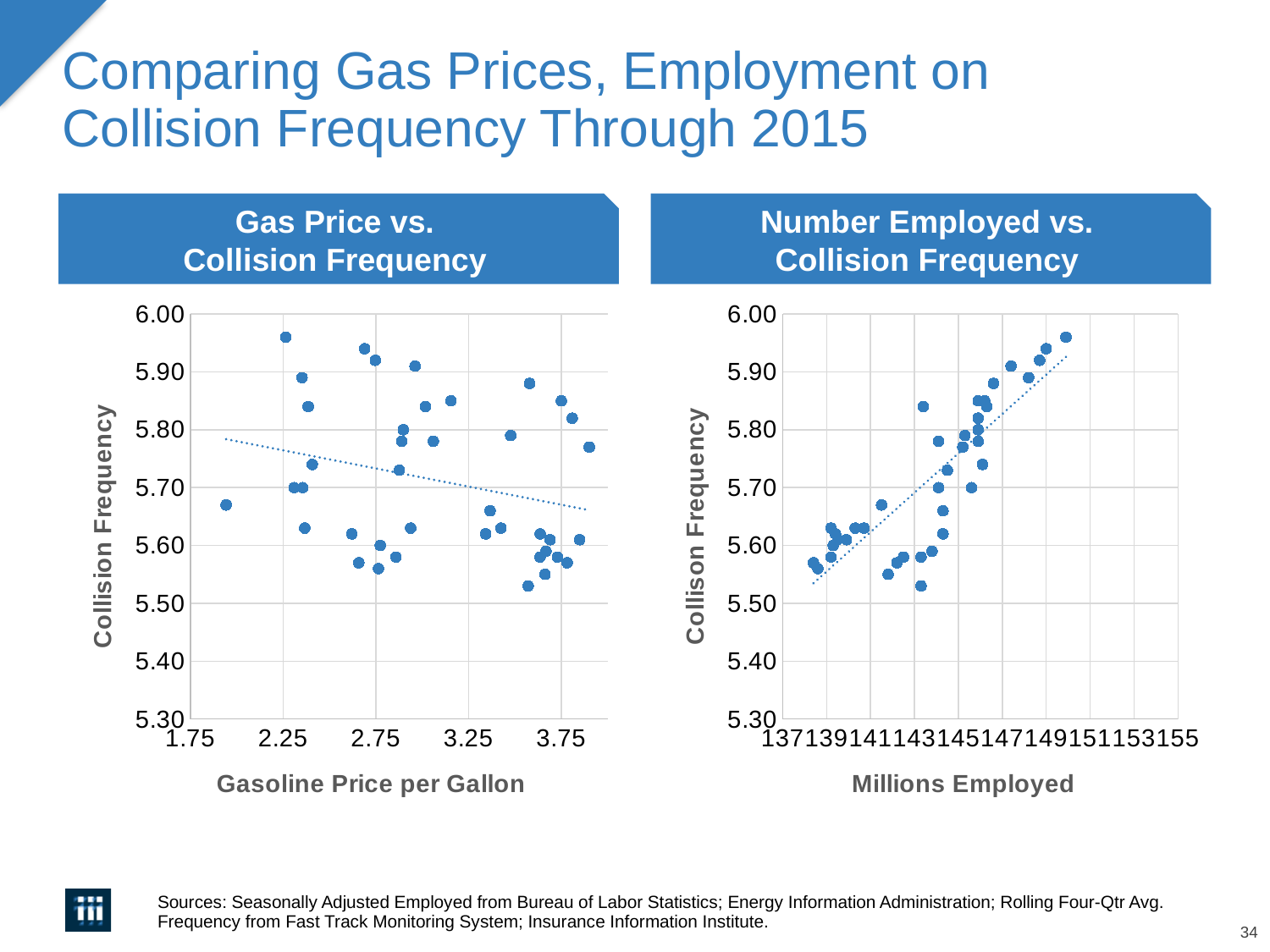
Which of the two charts shows a positive relationship between the x-axis variable and collision frequency? Number Employed vs. Collision Frequency What kind of chart is the 'Number Employed vs. Collision Frequency' chart? Scatter chart In the 'Number Employed vs. Collision Frequency' chart, are the collision frequencies of the points near 137-138 million employed greater or less than 5.70? less In the 'Gas Price vs. Collision Frequency' chart, is the collision frequency of the highest point (near a gas price of 2.25) greater or less than 5.90? greater What is the x-axis title of the 'Gas Price vs. Collision Frequency' chart? Gasoline Price per Gallon In the 'Gas Price vs. Collision Frequency' chart, is the collision frequency of the lowest point (near a gas price of 3.55) greater or less than 5.60? less What is the x-axis title of the 'Number Employed vs. Collision Frequency' chart? Millions Employed What kind of chart is the 'Gas Price vs. Collision Frequency' chart? Scatter chart In the 'Number Employed vs. Collision Frequency' chart, does the dotted trend line rise or fall as millions employed increases? Rise In the 'Gas Price vs. Collision Frequency' chart, does the dotted trend line rise or fall as gasoline price increases? Fall